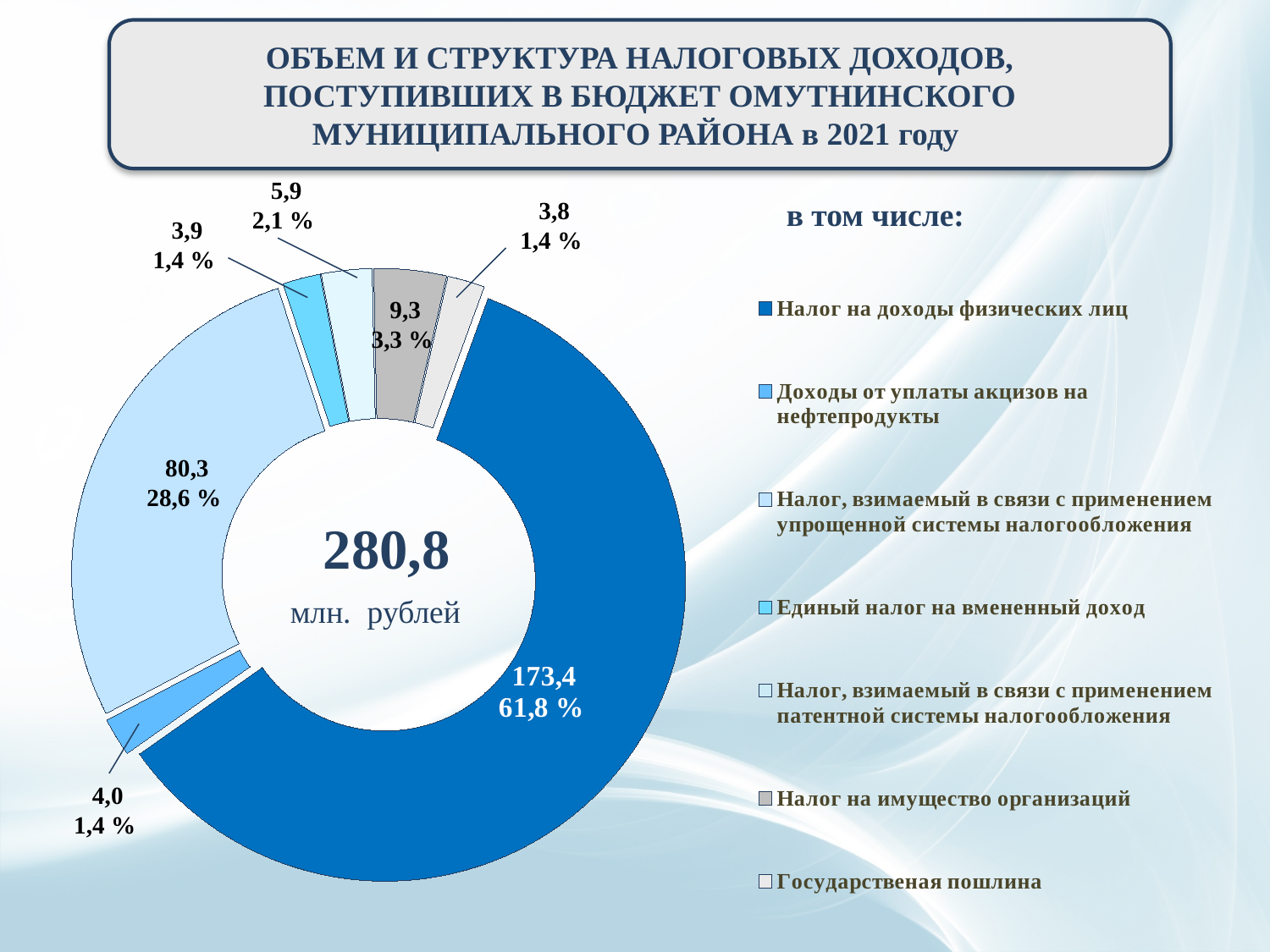
What share of the total does "Налог, взимаемый в связи с применением патентной системы налогообложения" represent? 2,1 % What is the value for "Налог на имущество организаций"? 9,3 What is the difference between the values for "Налог на доходы физических лиц" and "Налог, взимаемый в связи с применением упрощенной системы налогообложения"? 93,1 How many categories does the legend list? 7 What is the value for "Налог, взимаемый в связи с применением упрощенной системы налогообложения"? 80,3 Which category has the largest value? Налог на доходы физических лиц What share of the total does "Налог на доходы физических лиц" represent? 61,8 % Which is larger: the value for "Налог на имущество организаций" or for "Налог, взимаемый в связи с применением патентной системы налогообложения"? Налог на имущество организаций What type of chart is shown on the slide? doughnut (pie) chart What total value is shown in the centre of the chart? 280,8 млн. рублей What is the value for "Налог на доходы физических лиц"? 173,4 What year does the chart title refer to? 2021